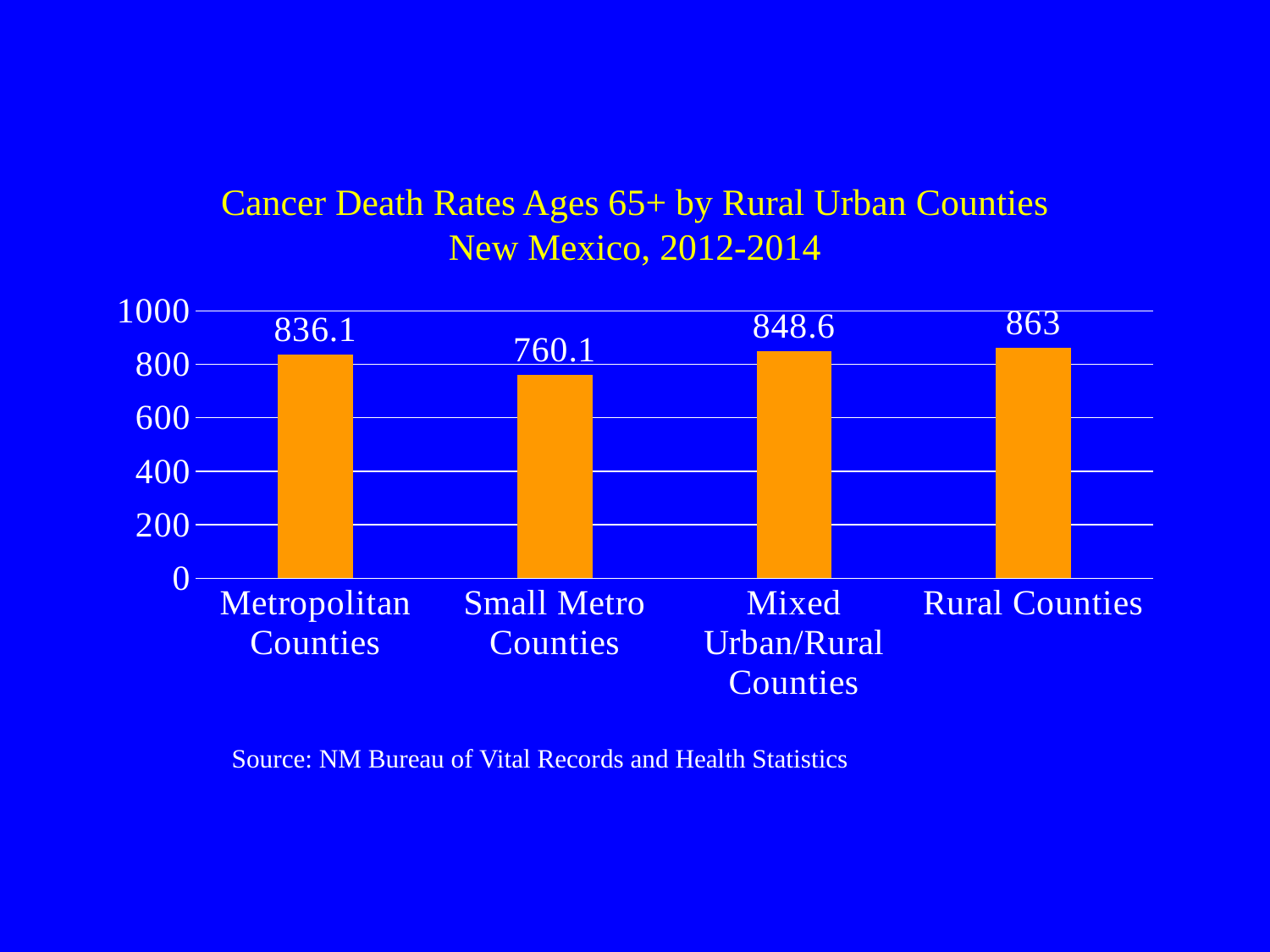
What is the cancer death rate for Mixed Urban/Rural Counties? 848.6 Is the value for Small Metro Counties greater or less than 800? less What is the cancer death rate for Rural Counties? 863 What is the difference between the cancer death rates for Rural Counties and Small Metro Counties? 102.9 How many county categories are shown in the chart? 4 Which has a higher cancer death rate, Metropolitan Counties or Small Metro Counties? Metropolitan Counties Which county type has the highest cancer death rate? Rural Counties What kind of chart is shown on the slide? Bar chart What is the cancer death rate for Metropolitan Counties? 836.1 Which county type has the lowest cancer death rate? Small Metro Counties What is the cancer death rate for Small Metro Counties? 760.1 What is the difference between the cancer death rates for Mixed Urban/Rural Counties and Metropolitan Counties? 12.5